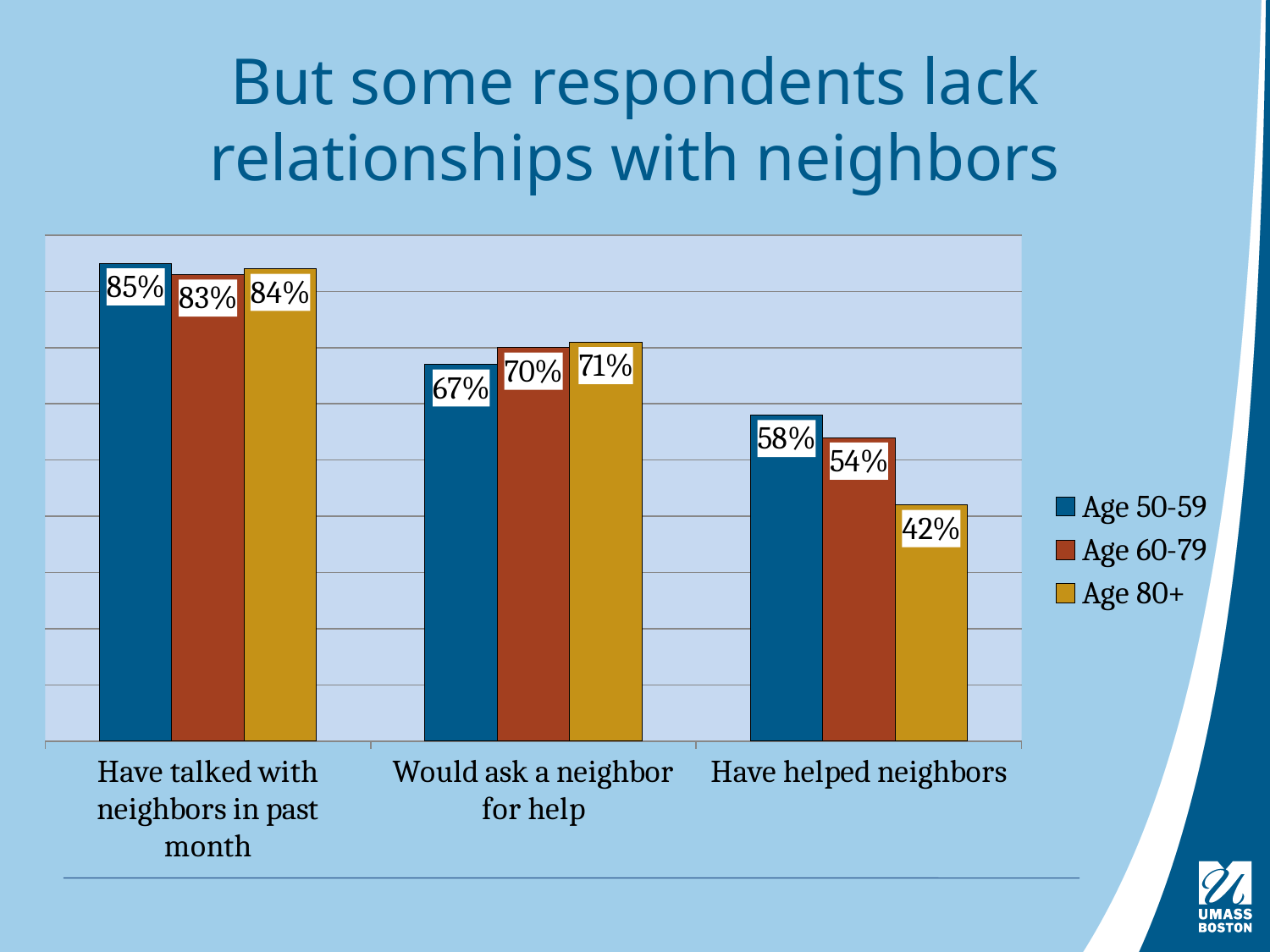
For 'Would ask a neighbor for help', which is larger: the value for Age 50-59 or Age 80+? Age 80+ What is the difference between the Age 50-59 and Age 80+ values for 'Have helped neighbors'? 16% What is the difference between the Age 80+ and Age 50-59 values for 'Would ask a neighbor for help'? 4% What percentage of respondents aged 60-79 would ask a neighbor for help? 70% What is the value for Age 80+ in the 'Have helped neighbors' category? 42% Which age group has the lowest value for 'Have helped neighbors'? Age 80+ What kind of chart is shown on the slide? Bar chart How many series does the legend list? 3 What percentage of respondents aged 50-59 have talked with neighbors in the past month? 85% How many categories are shown on the x axis? 3 Which colour represents the Age 60-79 series? Red Which age group has the highest value for 'Have talked with neighbors in past month'? Age 50-59